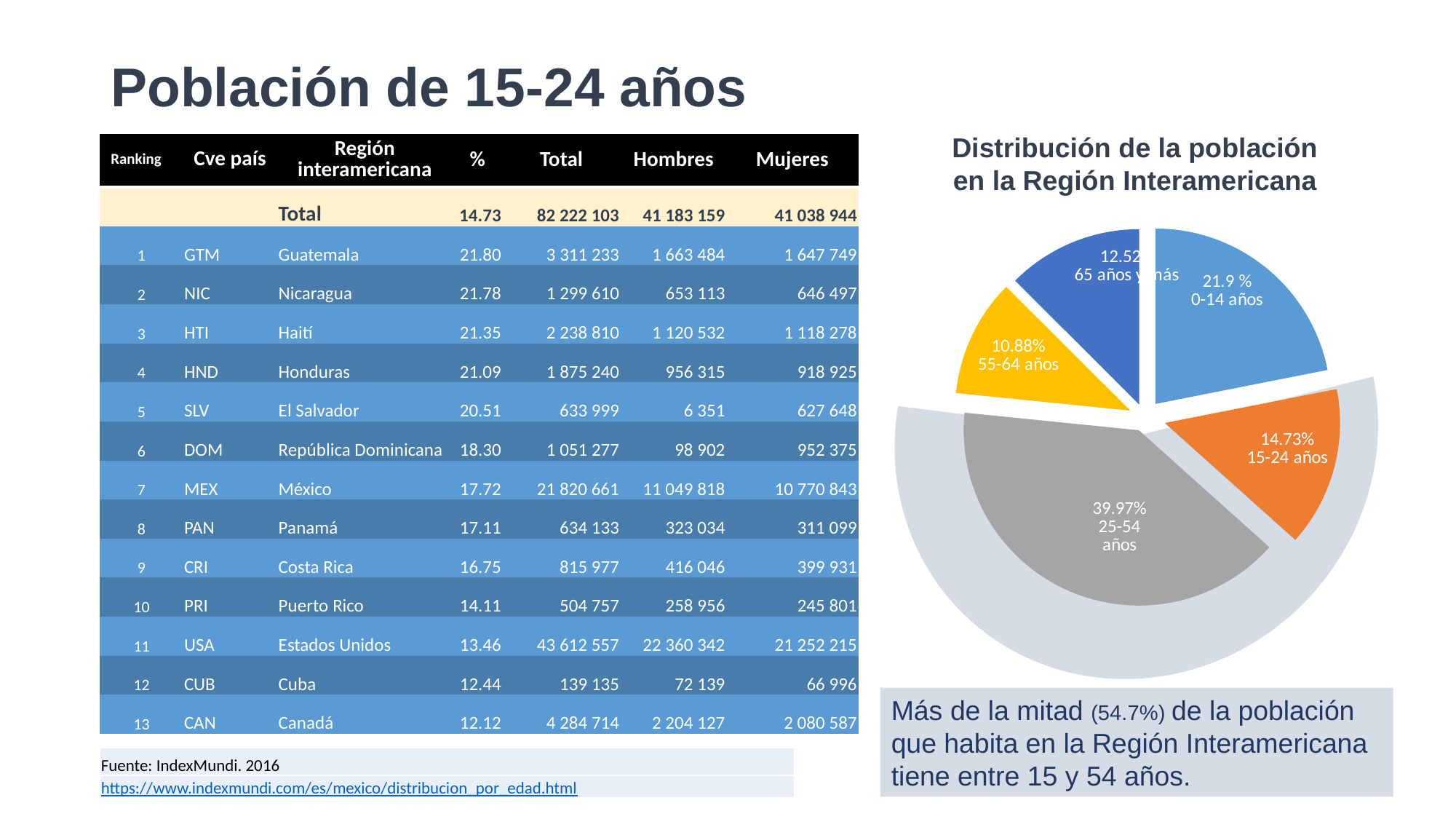
What share of the population is in the 15-24 años group according to the pie chart? 14.73% What share of the population is in the 0-14 años group according to the pie chart? 21.9 % How many slices does the pie chart have? 5 What kind of chart is shown on the right side of the slide? pie chart What share of the population is in the 25-54 años group according to the pie chart? 39.97% Which age group has the smallest slice in the pie chart? 55-64 años In the pie chart, which slice is larger: 0-14 años or 15-24 años? 0-14 años Which age group has the largest slice in the pie chart? 25-54 años What colour is the 15-24 años slice in the pie chart? orange What share of the population is in the 55-64 años group according to the pie chart? 10.88% What is the title of the pie chart? Distribución de la población en la Región Interamericana In the pie chart, how many percentage points larger is the 25-54 años slice than the 15-24 años slice? 25.24